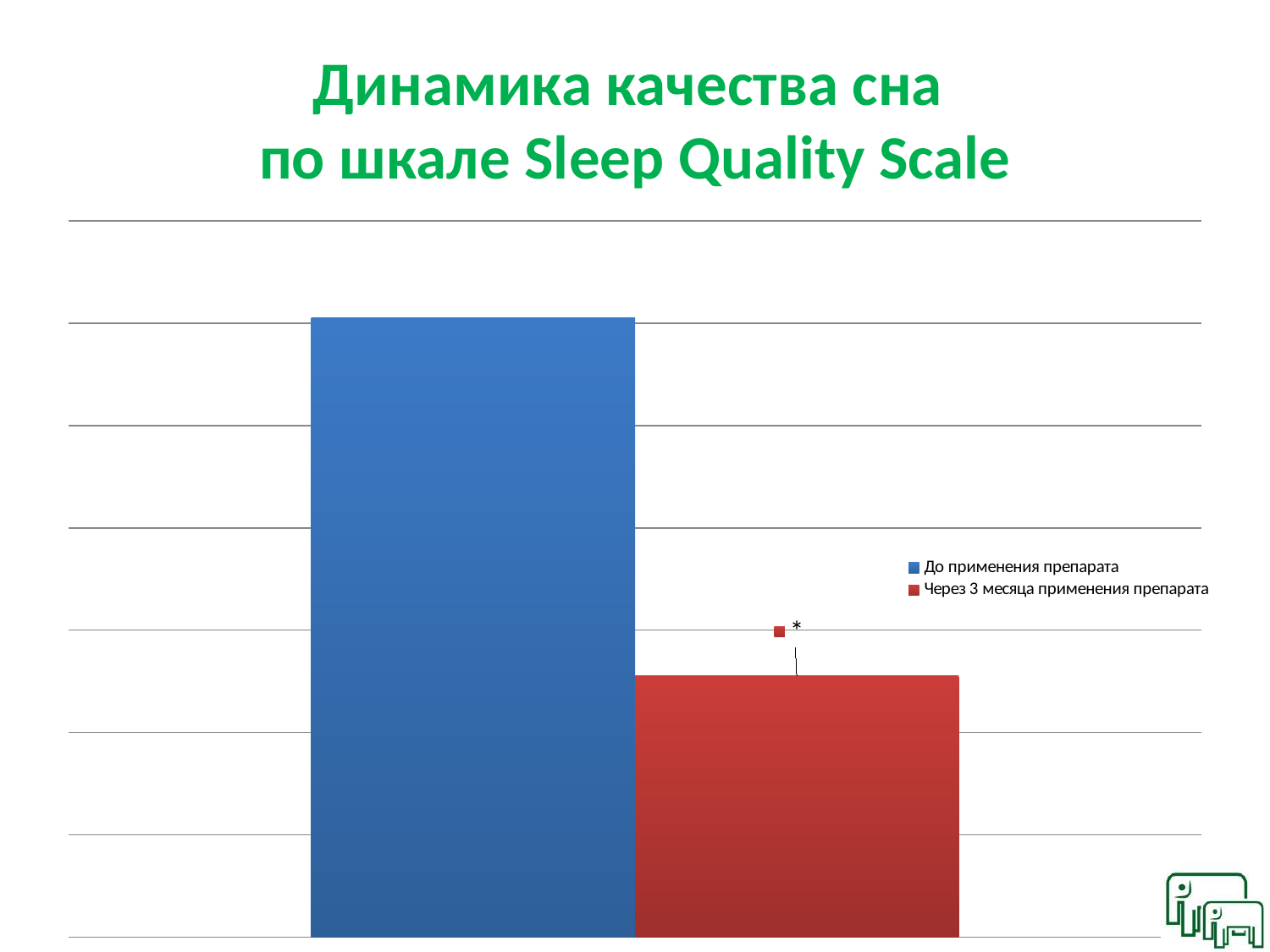
What colour is the bar for "Через 3 месяца применения препарата"? red What kind of chart is shown on the slide? bar chart Which series has the taller bar, "До применения препарата" or "Через 3 месяца применения препарата"? До применения препарата Which series has the lowest value in the chart? Через 3 месяца применения препарата Does the value rise or fall from "До применения препарата" to "Через 3 месяца применения препарата"? fall How many series does the legend list? 2 Which series has the highest value in the chart? До применения препарата What is the title of the chart on the slide? Динамика качества сна по шкале Sleep Quality Scale How many bars are plotted in the chart? 2